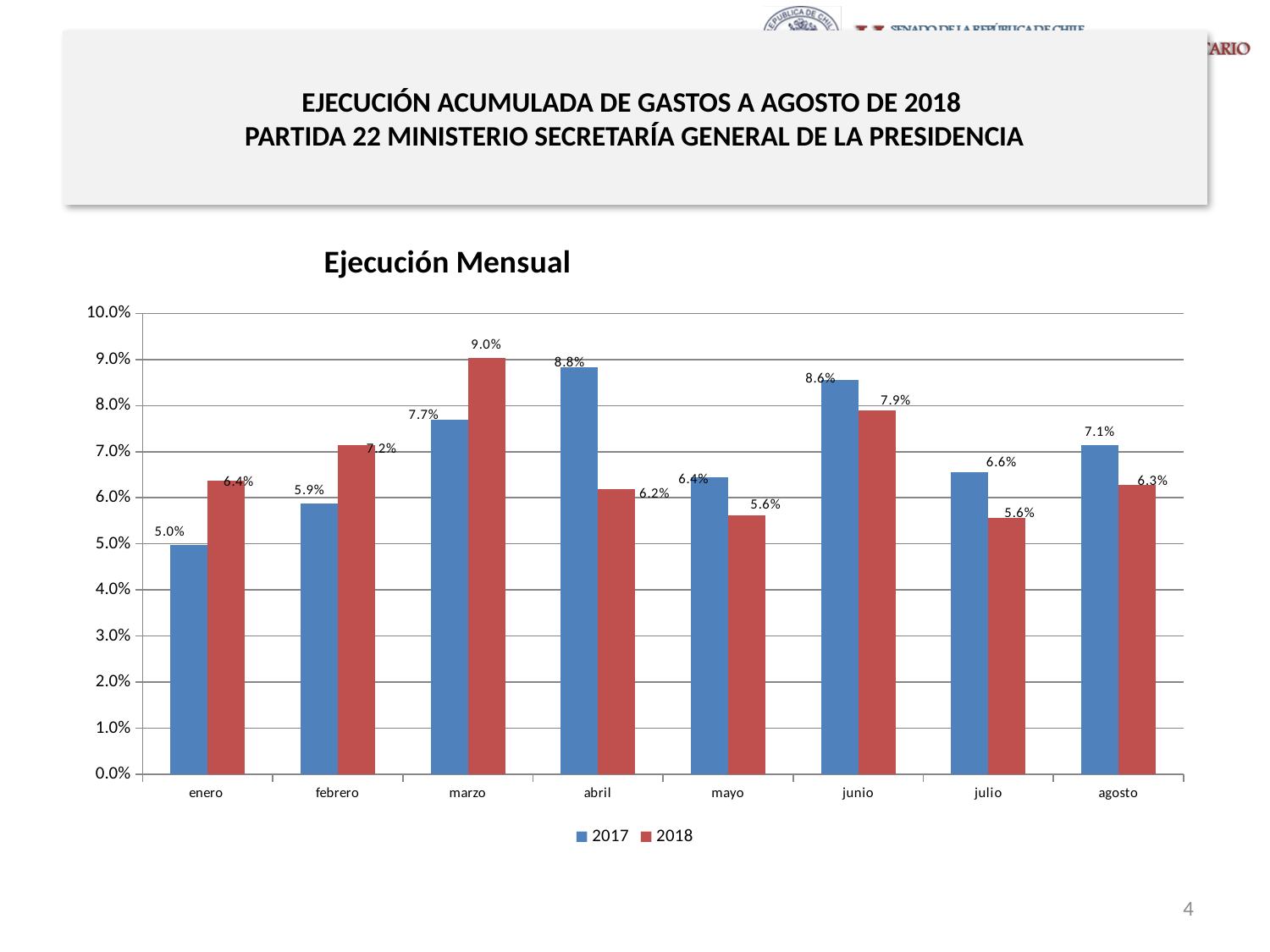
How many months are shown on the x axis? 8 Which month has the highest 2017 value? abril Which month has the lowest 2017 value? enero What is the difference between the 2018 and 2017 values for marzo? 1.3 percentage points Which month has the highest 2018 value? marzo What is the 2018 value for agosto? 6.3% How many series does the legend list? 2 What is the 2018 value for marzo? 9.0% What is the title of the chart? Ejecución Mensual What type of chart is shown on the slide? bar chart For junio, which is larger, the 2017 value or the 2018 value? 2017 What is the 2017 value for abril? 8.8%